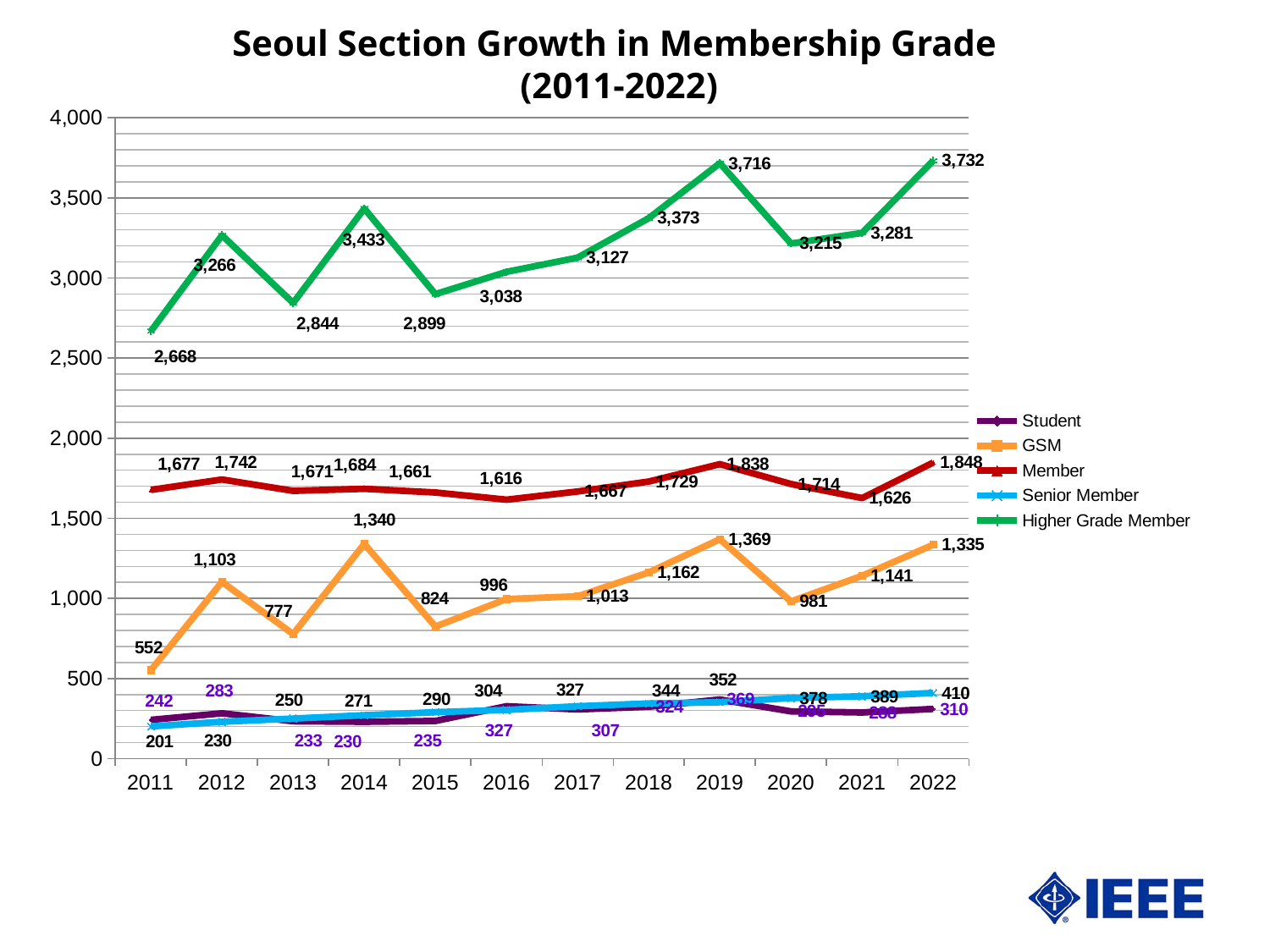
What is the difference between the Member value in 2022 and in 2011? 171 Does the Senior Member series rise or fall from 2011 to 2022? Rise Is the Higher Grade Member value for 2011 greater or less than 3,000? less Which year has the larger GSM value, 2014 or 2019? 2019 How many series does the legend list? 5 In which year is the Higher Grade Member value highest? 2022 What kind of chart is shown on the slide? Line chart In which year is the GSM value lowest? 2011 How many years are plotted along the x axis? 12 What is the Senior Member value for 2022? 410 What is the Higher Grade Member value for 2022? 3,732 What colour is the Higher Grade Member line? Green